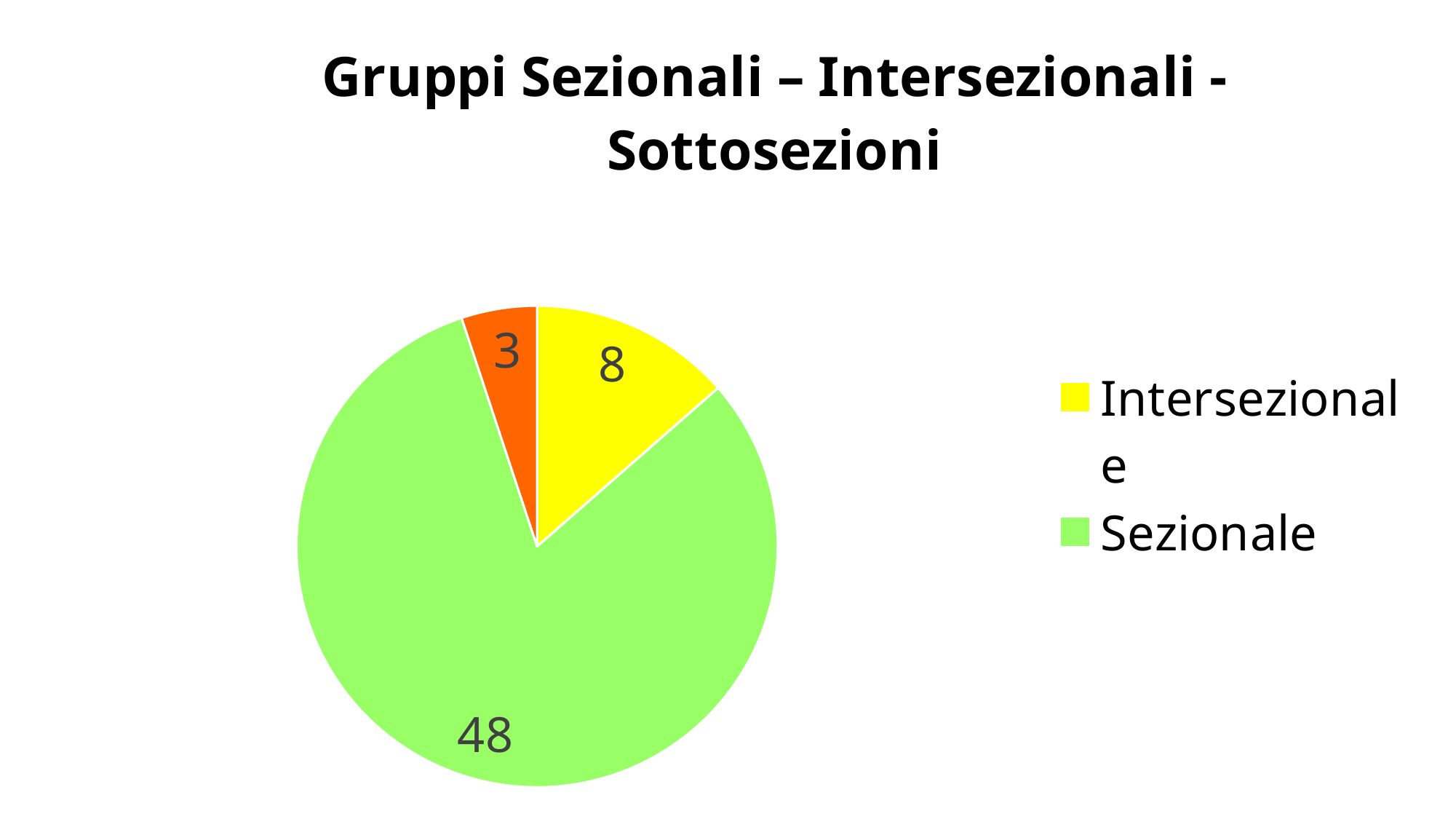
What value is printed on the smallest slice of the pie? 3 What type of chart is shown on the slide? pie chart What is the title of the chart? Gruppi Sezionali – Intersezionali - Sottosezioni What is the difference between the Sezionale value and the Intersezionale value? 40 What is the sum of all the values printed on the pie chart? 59 Which is larger, the Sezionale slice or the Intersezionale slice? Sezionale How many slices does the pie chart have? 3 What is the value shown for Intersezionale? 8 What is the value shown for Sezionale? 48 How many entries does the legend list? 2 Which legend category has the largest slice of the pie? Sezionale What colour is the Sezionale slice? green